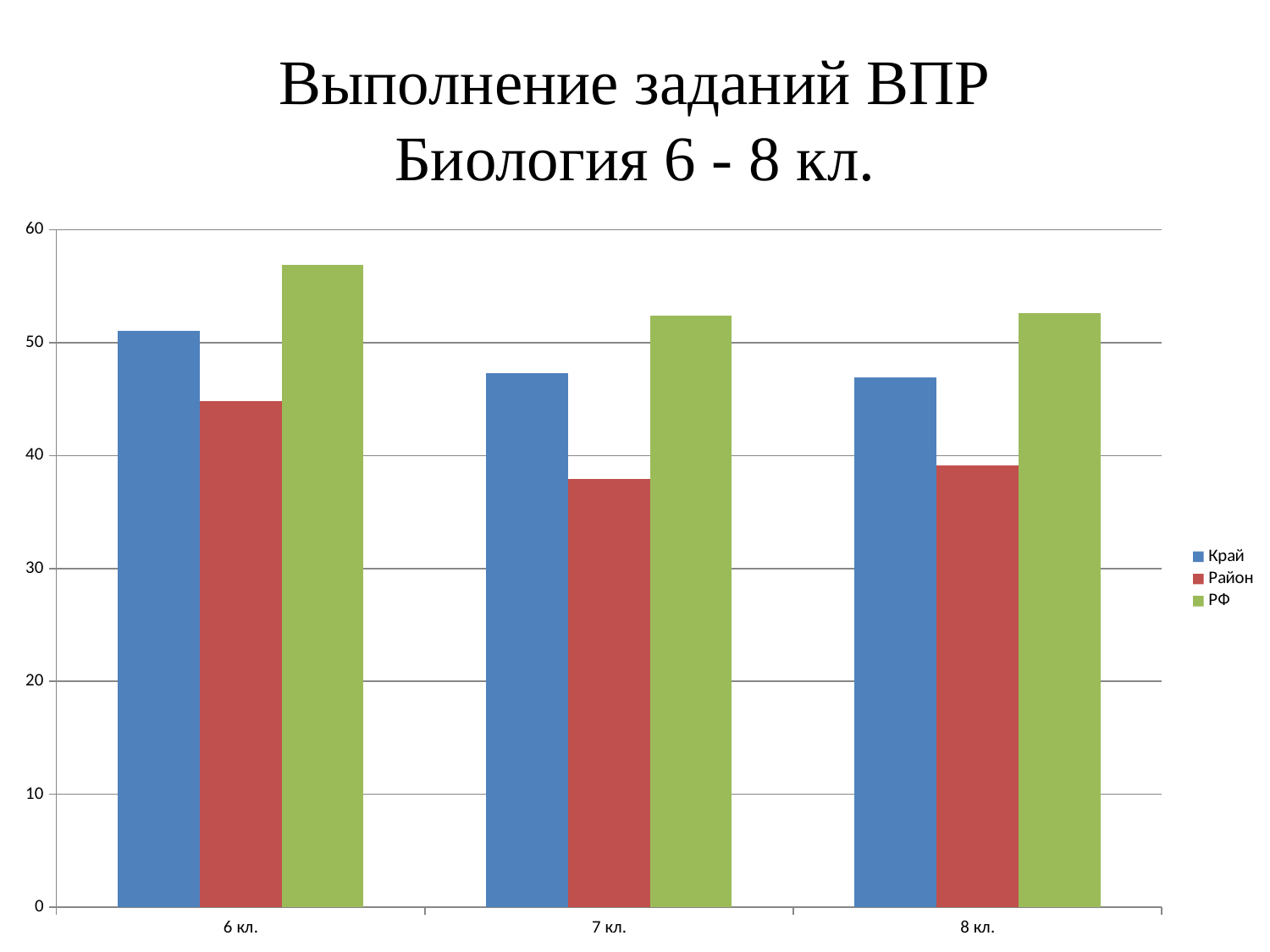
Which series has the highest bar for 6 кл.? РФ How many categories are shown on the x axis? 3 What is the title of the chart? Выполнение заданий ВПР Биология 6 - 8 кл. What kind of chart is shown on the slide? bar chart Is the value for РФ in 6 кл. greater or less than 50? greater Which series has the lowest bar for 7 кл.? Район Is the value for Край in 8 кл. greater or less than 50? less Which category has the highest РФ value? 6 кл. How many series does the legend list? 3 Which is larger for 6 кл.: Край or Район? Край Does the Край value rise or fall from 6 кл. to 7 кл.? fall Is the value for Район in 7 кл. greater or less than 40? less